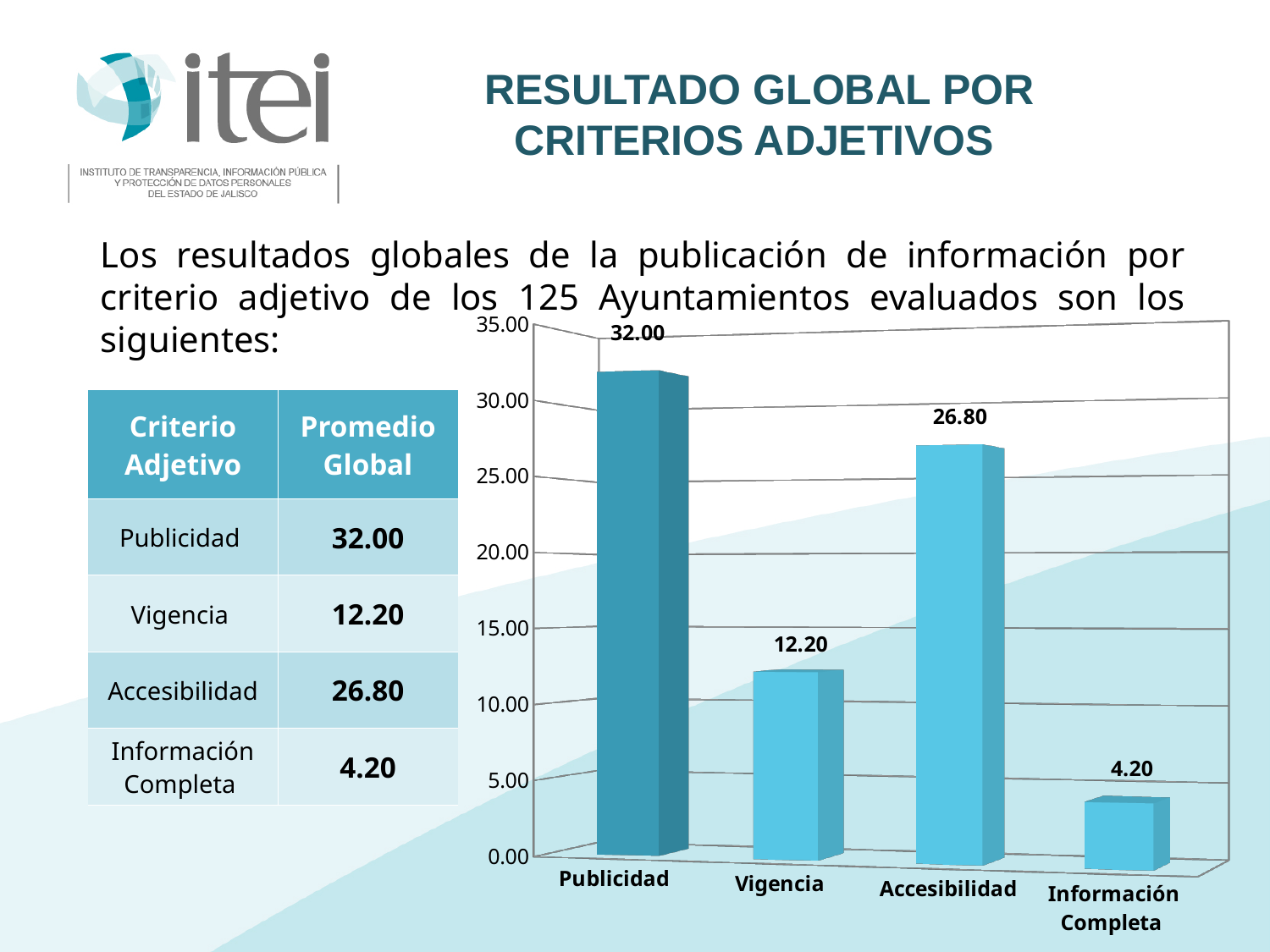
What is the difference between the values for Publicidad and Accesibilidad? 5.20 What is the value for Publicidad in the chart? 32.00 How many categories are shown in the chart? 4 What is the value for Vigencia in the chart? 12.20 Which category has the highest value in the chart? Publicidad Which is larger, the value for Vigencia or the value for Accesibilidad? Accesibilidad What is the value for Información Completa in the chart? 4.20 Is the value for Accesibilidad greater or less than 25.00? greater Which category has the lowest value in the chart? Información Completa What kind of chart is shown on the slide? Bar chart What is the difference between the values for Vigencia and Información Completa? 8.00 What is the value for Accesibilidad in the chart? 26.80